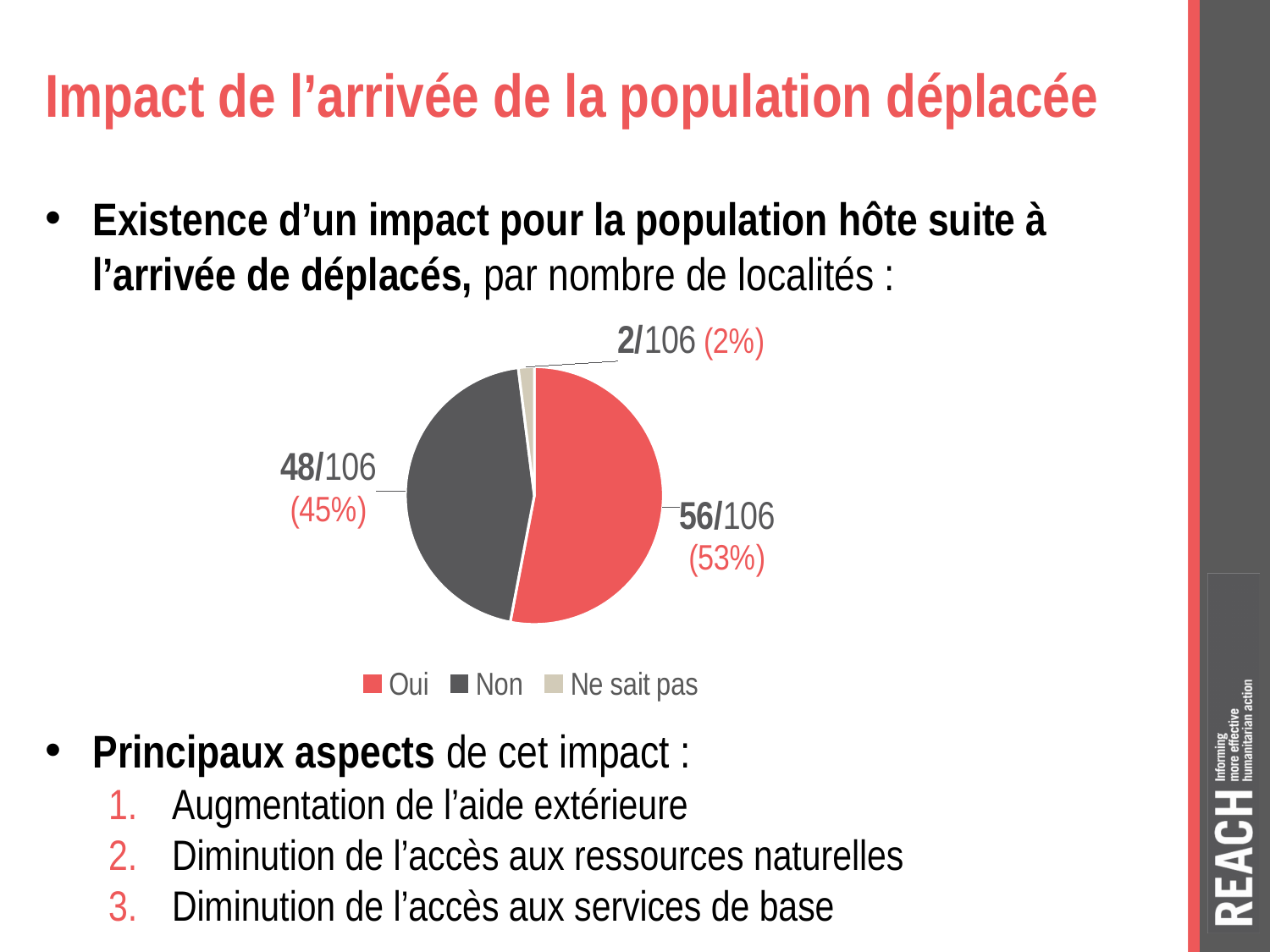
What percentage of localities answered "Oui"? 53% How many categories does the legend list? 3 What kind of chart is shown on the slide? pie chart What percentage of localities answered "Non"? 45% What percentage of localities answered "Ne sait pas"? 2% What is the difference in number of localities between "Oui" and "Non"? 8 How many localities answered "Oui"? 56/106 How many localities answered "Non"? 48/106 Which response category has the smallest slice of the pie? Ne sait pas Which colour represents "Non" in the pie chart? dark grey How many localities answered "Ne sait pas"? 2/106 Which response category has the largest slice of the pie? Oui